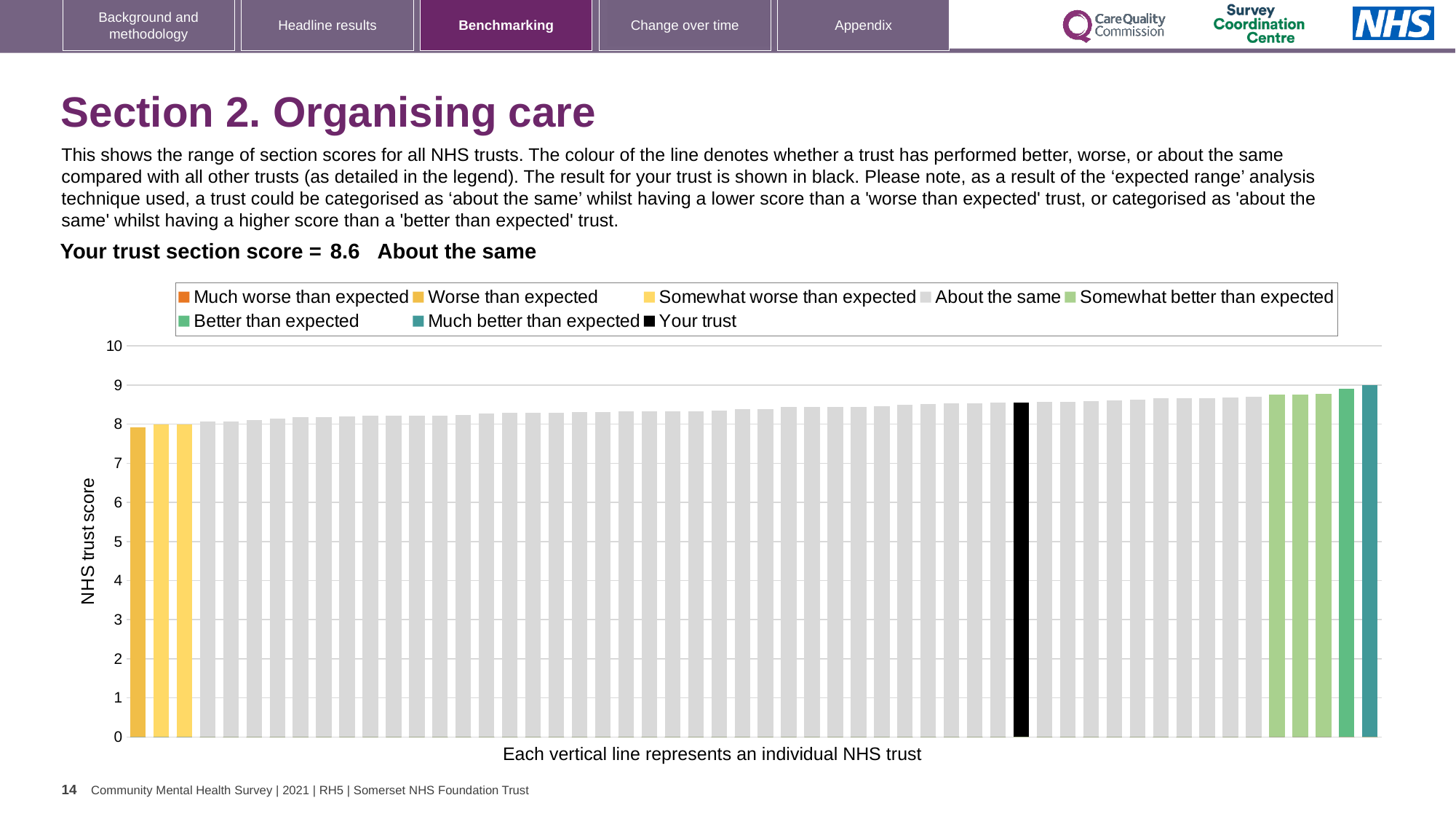
What is the section score for your trust shown on the slide? 8.6 Which category is your trust's section score placed in? About the same Do the bar values rise or fall from left to right along the x axis? rise Is the value for your trust greater or less than 8? greater How many entries does the chart legend list? 8 Is the value of the tallest bar greater or less than 8? greater What is the label on the vertical axis of the chart? NHS trust score Which is larger, the black bar for your trust or the leftmost bar? the black bar for your trust What kind of chart is shown on the slide? bar chart Which is larger, the leftmost bar or the rightmost bar? the rightmost bar Is the value of the shortest bar greater or less than 7? greater Which legend category does the tallest bar belong to? Much better than expected